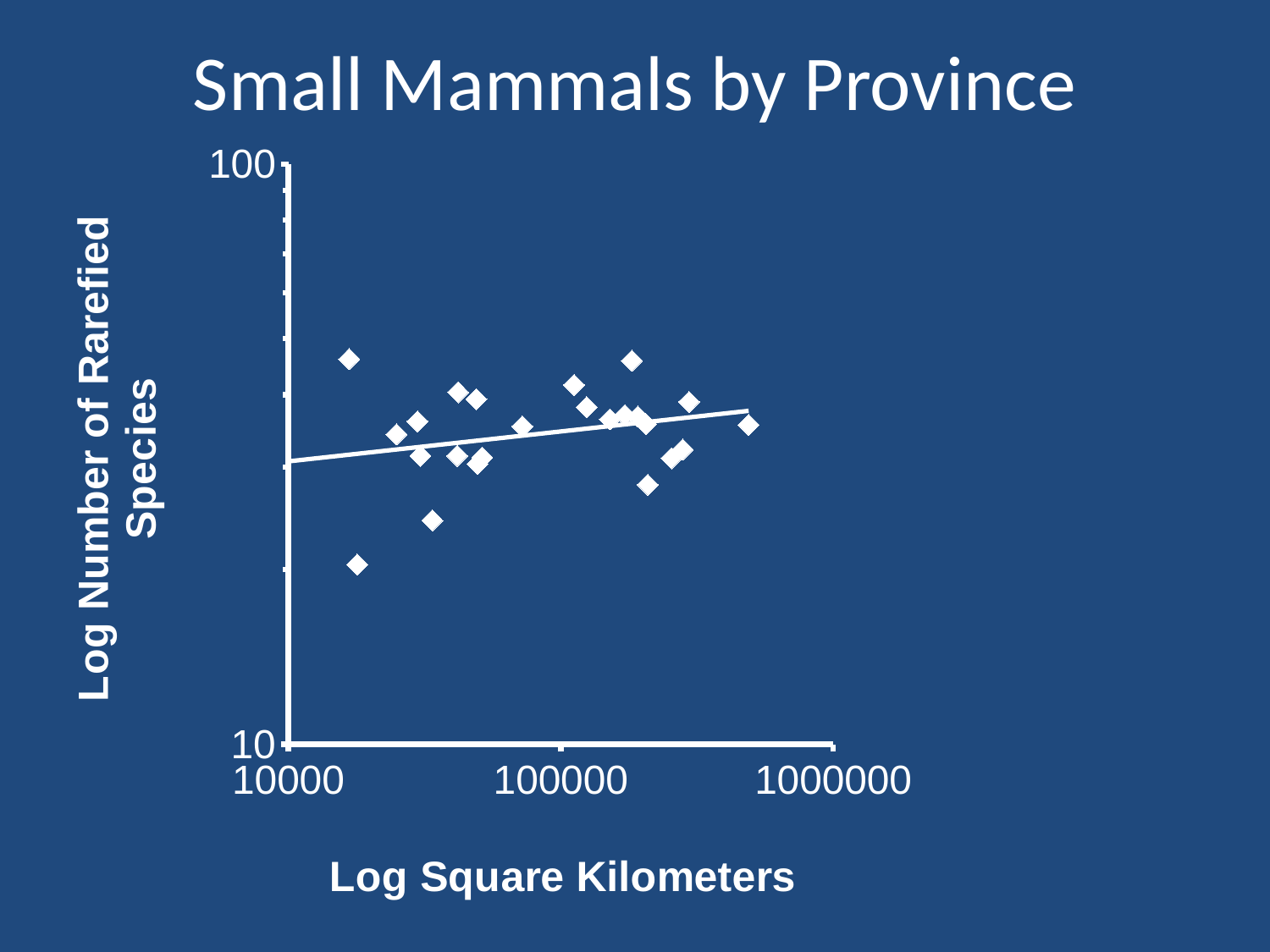
What is the title of the chart? Small Mammals by Province Is the lowest plotted point greater or less than 10 on the y axis? greater What kind of chart is shown on the slide? scatter chart What is the largest value shown on the x axis? 1000000 What is the bottom value shown on the y axis? 10 Is the highest plotted point greater or less than 100 on the y axis? less Is the point with the smallest x value greater or less than 10 on the y axis? greater What is the label of the x axis? Log Square Kilometers What is the top value shown on the y axis? 100 Does the fitted trend line rise or fall as Log Square Kilometers increases? rise What is the smallest value shown on the x axis? 10000